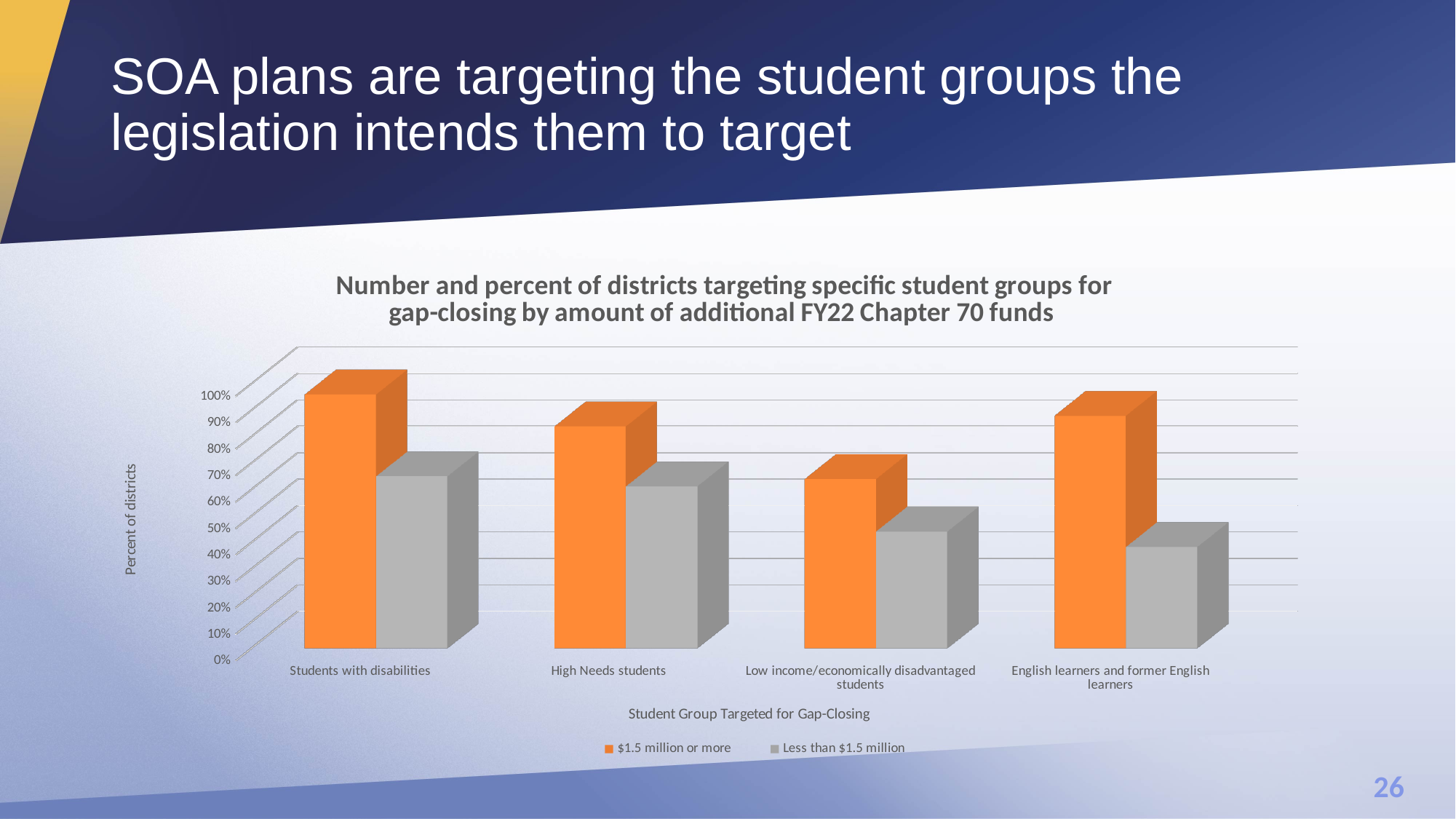
Which series is shown in orange? $1.5 million or more How many series does the legend list? 2 Is the value for English learners and former English learners in the Less than $1.5 million series greater or less than 50%? less How many student group categories are shown on the x axis? 4 Which student group has the highest value for the $1.5 million or more series? Students with disabilities Is the value for Low income/economically disadvantaged students in the $1.5 million or more series greater or less than 80%? less Is the value for High Needs students in the $1.5 million or more series greater or less than 70%? greater For English learners and former English learners, which series has the larger value: $1.5 million or more, or Less than $1.5 million? $1.5 million or more For Low income/economically disadvantaged students, which series has the smaller value: $1.5 million or more, or Less than $1.5 million? Less than $1.5 million What kind of chart is shown on the slide? bar chart What is the label of the y axis? Percent of districts Which student group has the lowest value for the $1.5 million or more series? Low income/economically disadvantaged students